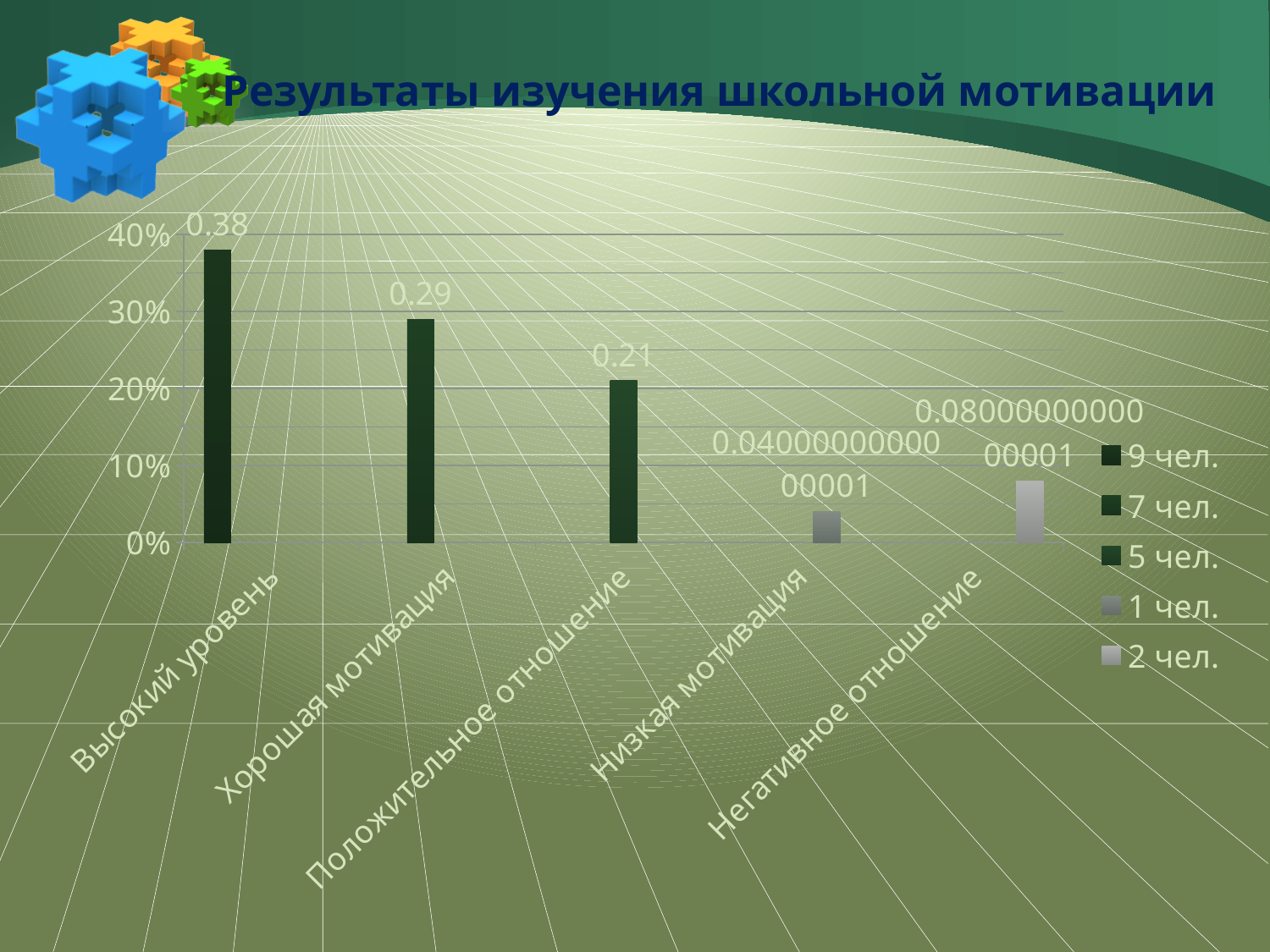
How many entries does the legend list? 5 What is the value shown for Положительное отношение? 0.21 Which category has the lowest value? Низкая мотивация How many categories are shown on the x axis? 5 What kind of chart is shown on the slide? bar chart What is the difference between the values for Высокий уровень and Хорошая мотивация? 0.09 Which category has the highest value? Высокий уровень What is the value shown for Хорошая мотивация? 0.29 Which is larger, the value for Хорошая мотивация or the value for Положительное отношение? Хорошая мотивация What is the difference between the values for Хорошая мотивация and Положительное отношение? 0.08 What is the value shown for Высокий уровень? 0.38 Is the value for Негативное отношение greater or less than 10%? less